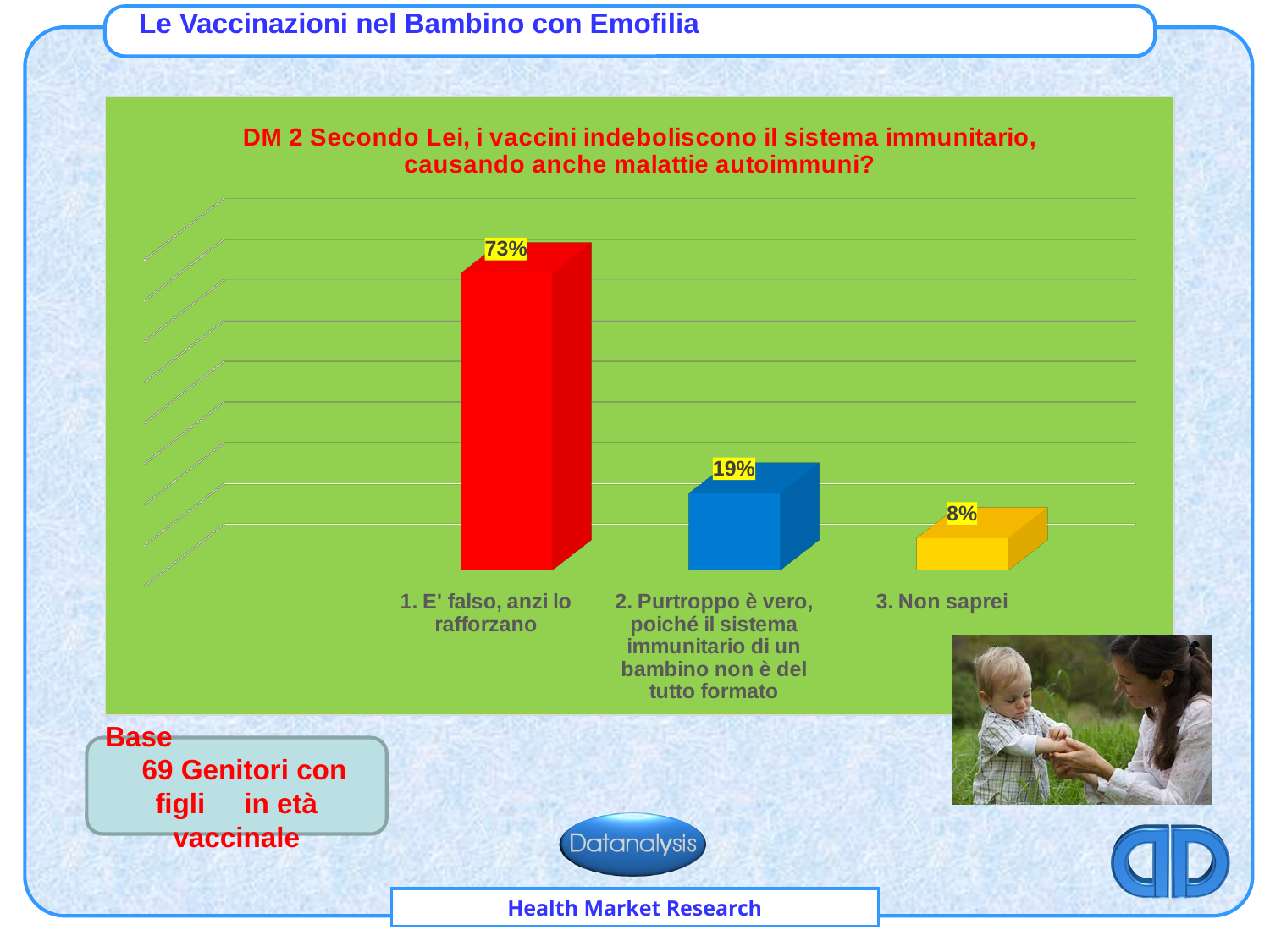
Which is larger: the value for "2. Purtroppo è vero..." or the value for "3. Non saprei"? 2. Purtroppo è vero... What percentage of respondents answered "3. Non saprei"? 8% What kind of chart is shown on the slide? Bar chart What percentage of respondents answered "1. E' falso, anzi lo rafforzano"? 73% Which answer option has the lowest percentage? 3. Non saprei Which answer option has the highest percentage? 1. E' falso, anzi lo rafforzano Do the values rise or fall from left to right across the categories? Fall What is the difference in percentage points between "2. Purtroppo è vero..." and "3. Non saprei"? 11 What percentage of respondents answered "2. Purtroppo è vero, poiché il sistema immunitario di un bambino non è del tutto formato"? 19% What colour is the bar for "1. E' falso, anzi lo rafforzano"? Red How many answer categories are shown in the chart? 3 What is the difference in percentage points between "1. E' falso, anzi lo rafforzano" and "2. Purtroppo è vero..."? 54